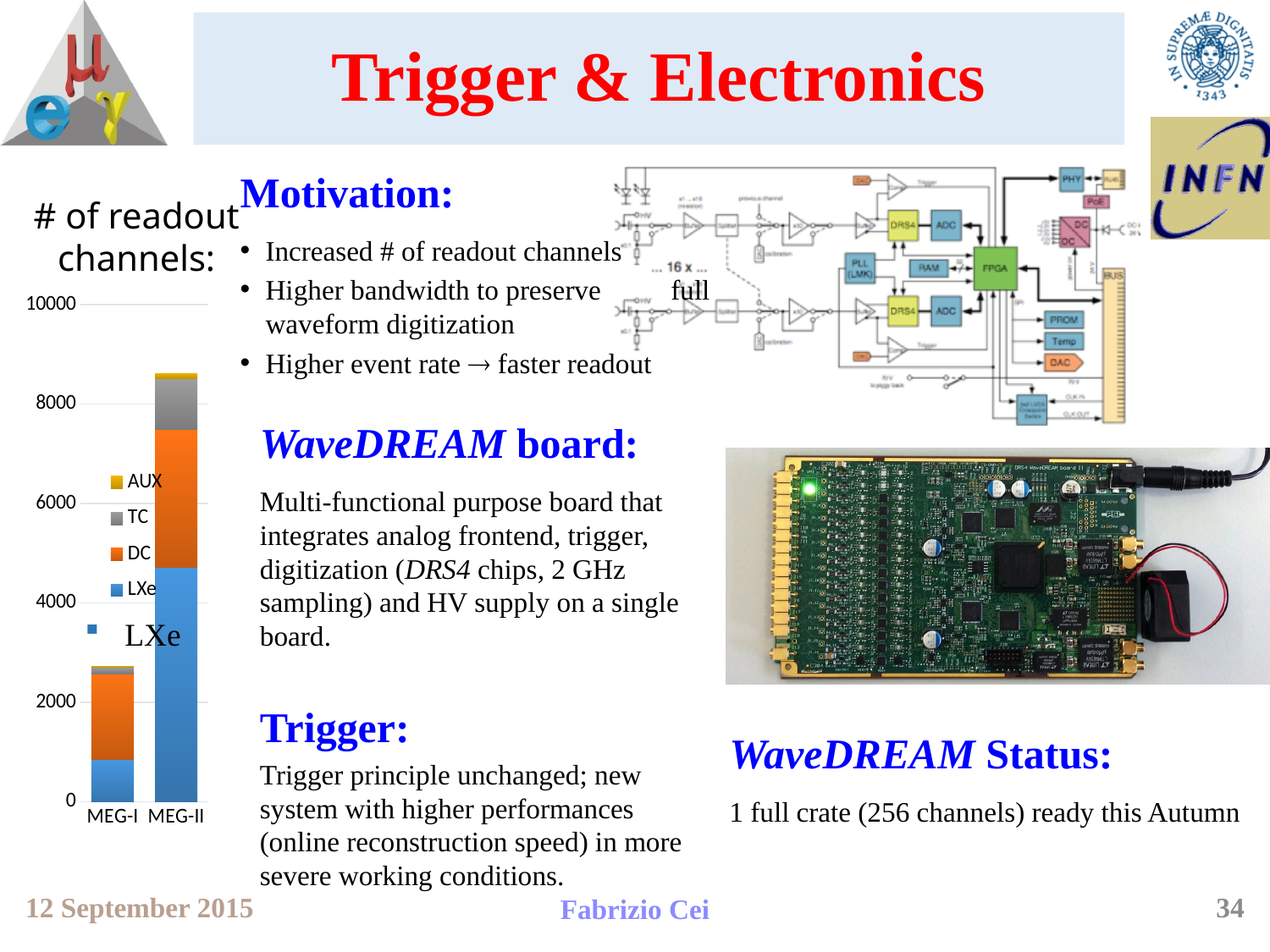
How many categories are shown on the x axis of the '# of readout channels' chart? 2 Which category has the taller stacked bar in the '# of readout channels' chart, MEG-I or MEG-II? MEG-II Which series is shown in blue in the '# of readout channels' chart? LXe Which category has the highest total number of readout channels? MEG-II Is the LXe value for MEG-II greater or less than 4000? greater Do the total readout channels rise or fall from MEG-I to MEG-II? rise Is the total number of readout channels for MEG-II greater or less than 8000? greater What kind of chart is the '# of readout channels' chart? stacked bar chart Is the LXe value for MEG-I greater or less than 2000? less Which category has the lowest total number of readout channels? MEG-I How many series does the legend of the '# of readout channels' chart list? 4